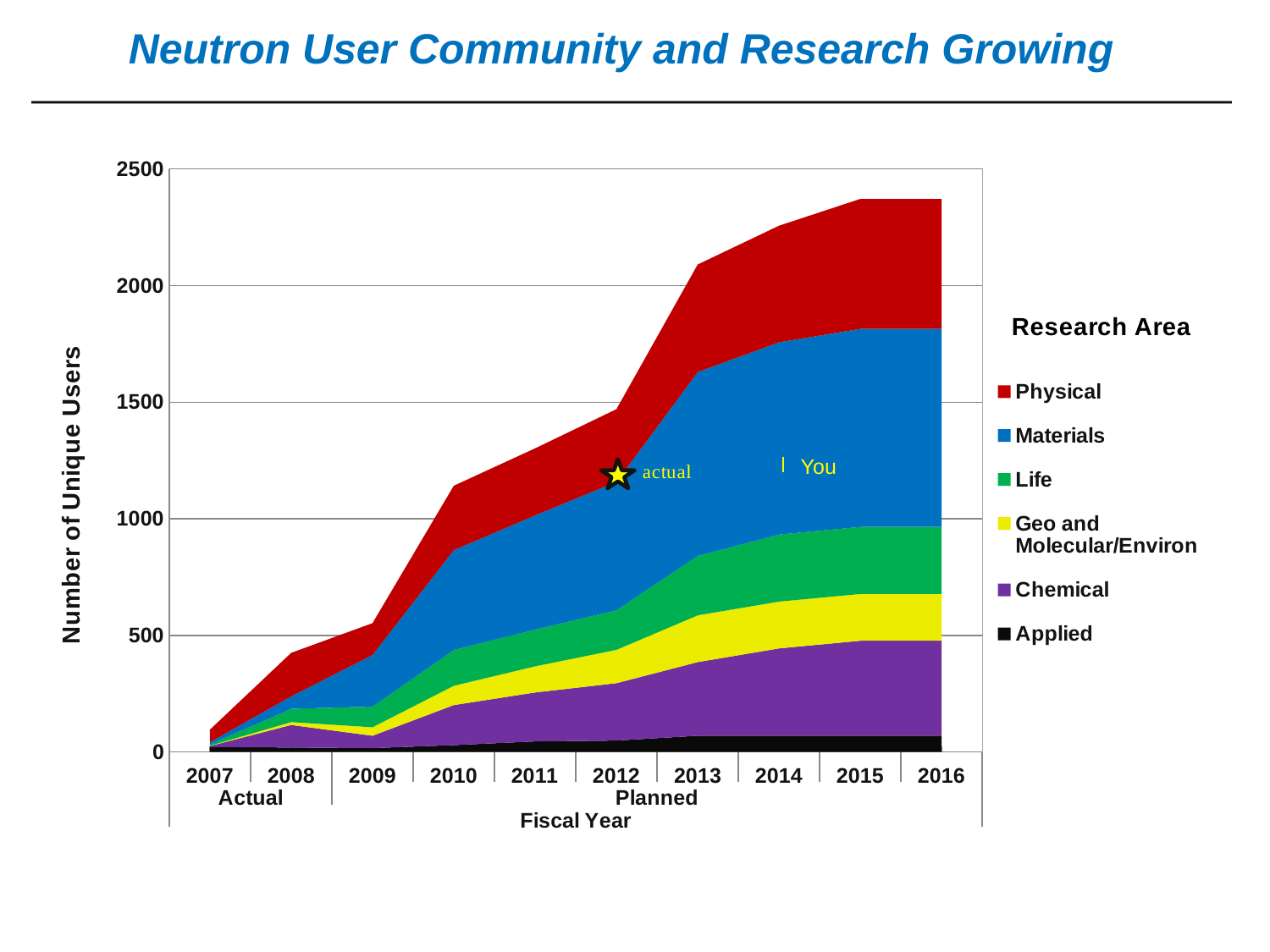
Is the total number of unique users in 2011 greater or less than 1500? less How many research areas does the legend list? 6 Is the total number of unique users in 2016 greater or less than 2000? greater What is the label of the y axis? Number of Unique Users Does the total number of unique users rise or fall from 2007 to 2016? Rise Is the total number of unique users in 2010 greater or less than 1000? greater What is the title of the chart's legend? Research Area How many fiscal years are shown along the x axis? 10 What kind of chart is shown on the slide? Stacked area chart Which fiscal year has the highest total number of unique users? 2015 and 2016 (tied)